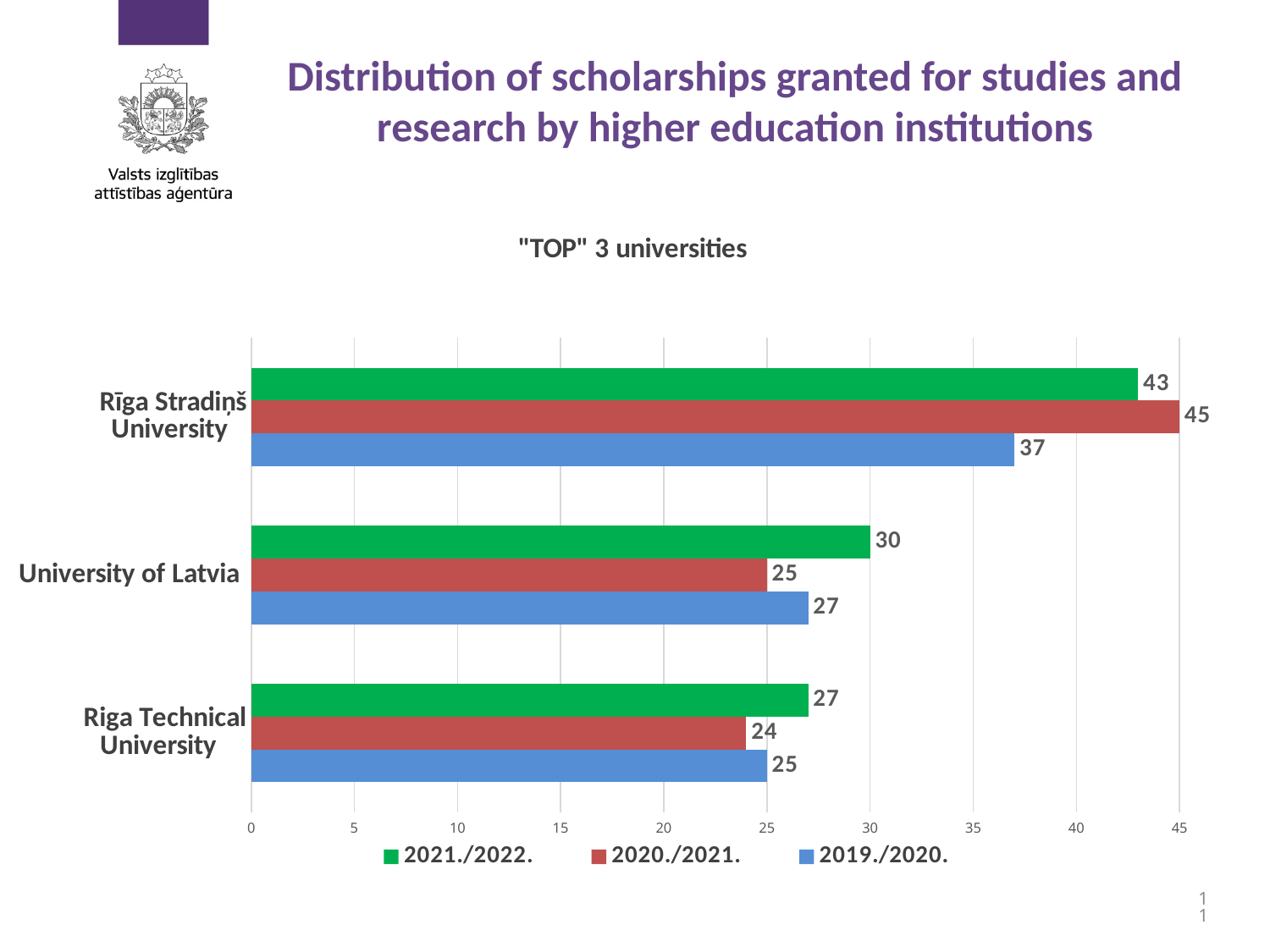
Which is larger for University of Latvia: the 2019./2020. value or the 2020./2021. value? 2019./2020. What kind of chart is shown on the slide? Bar chart Which colour represents the 2019./2020. series? Blue What is the difference between the 2020./2021. and 2019./2020. values for Rīga Stradiņš University? 8 What is the value for Riga Technical University in the 2019./2020. series? 25 Which university has the lowest value in the 2020./2021. series? Riga Technical University What is the title of the chart? "TOP" 3 universities How many series does the legend list? 3 What is the value for Rīga Stradiņš University in the 2020./2021. series? 45 What is the value for University of Latvia in the 2021./2022. series? 30 Which university has the highest value in the 2021./2022. series? Rīga Stradiņš University How many universities are shown on the chart? 3